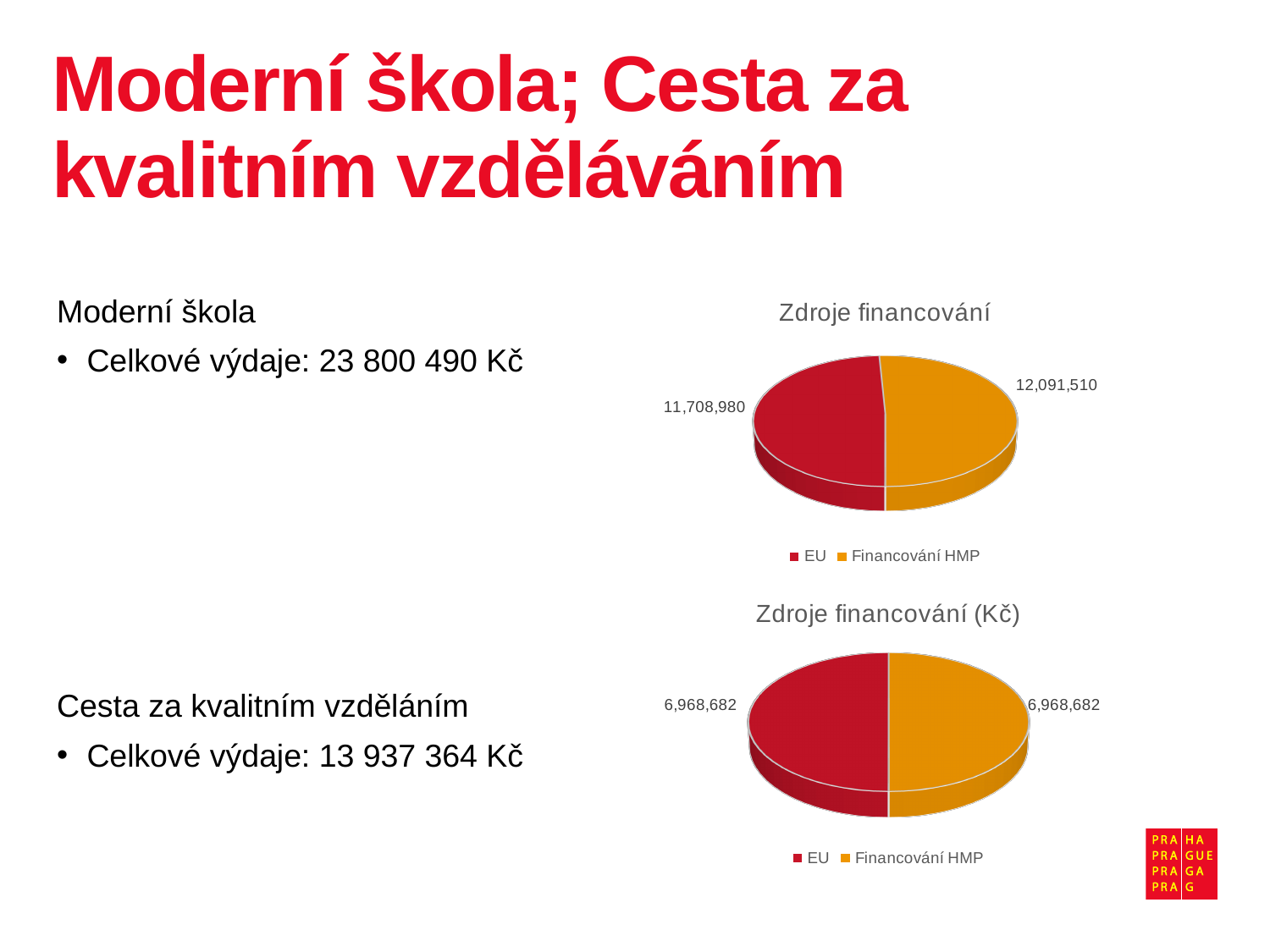
In the top chart titled "Zdroje financování", what is the total of the two slices? 23,800,490 In the bottom chart titled "Zdroje financování (Kč)", what is the value for Financování HMP? 6,968,682 In the top chart titled "Zdroje financování", which source has the larger value, EU or Financování HMP? Financování HMP In the top chart titled "Zdroje financování", what is the difference between the Financování HMP value and the EU value? 382,530 How many slices does the bottom chart titled "Zdroje financování (Kč)" have? 2 In the top chart titled "Zdroje financování", what is the value for EU? 11,708,980 What type of chart is the top chart titled "Zdroje financování"? Pie chart In the top chart titled "Zdroje financování", what is the value for Financování HMP? 12,091,510 In the bottom chart titled "Zdroje financování (Kč)", what is the total of the two slices? 13,937,364 In the bottom chart titled "Zdroje financování (Kč)", what is the value for EU? 6,968,682 In the bottom chart titled "Zdroje financování (Kč)", what share of the pie does the EU slice represent? 50% How many entries does the legend of the top chart titled "Zdroje financování" list? 2